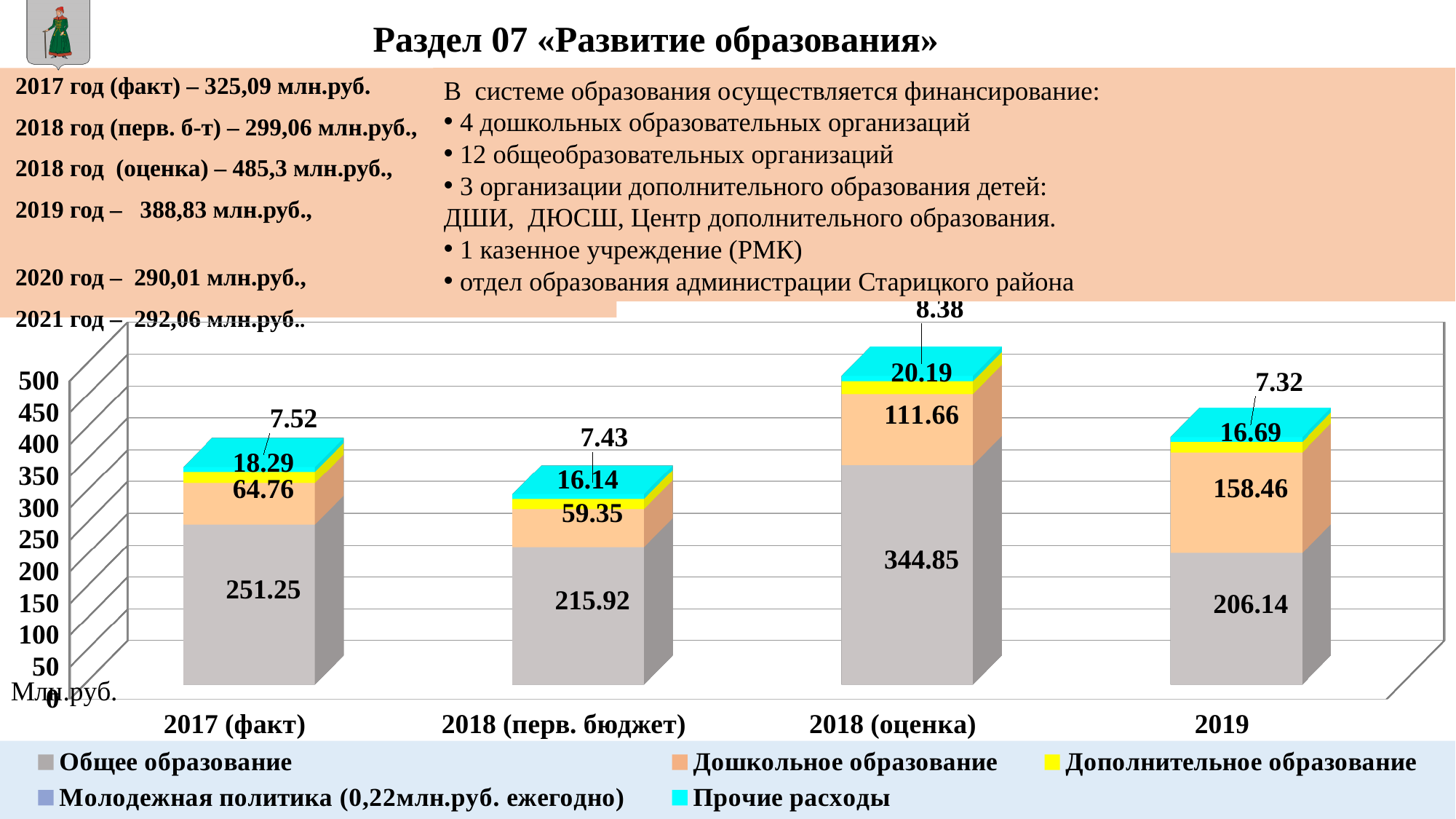
Which category has the lowest value for Дошкольное образование? 2018 (перв. бюджет) Which is larger: Дошкольное образование for 2019 or for 2018 (оценка)? 2019 Which colour represents Прочие расходы in the chart legend? cyan Which category has the highest value for Общее образование? 2018 (оценка) What is the value of Дошкольное образование for 2019? 158.46 How many series does the chart legend list? 5 What is the value of Прочие расходы for 2018 (перв. бюджет)? 7.43 What is the value of Общее образование for 2018 (оценка)? 344.85 How many categories are shown on the x axis of the chart? 4 What is the value of Дополнительное образование for 2017 (факт)? 18.29 What type of chart is shown on the slide? stacked bar chart What is the difference between Общее образование for 2017 (факт) and 2018 (перв. бюджет)? 35.33